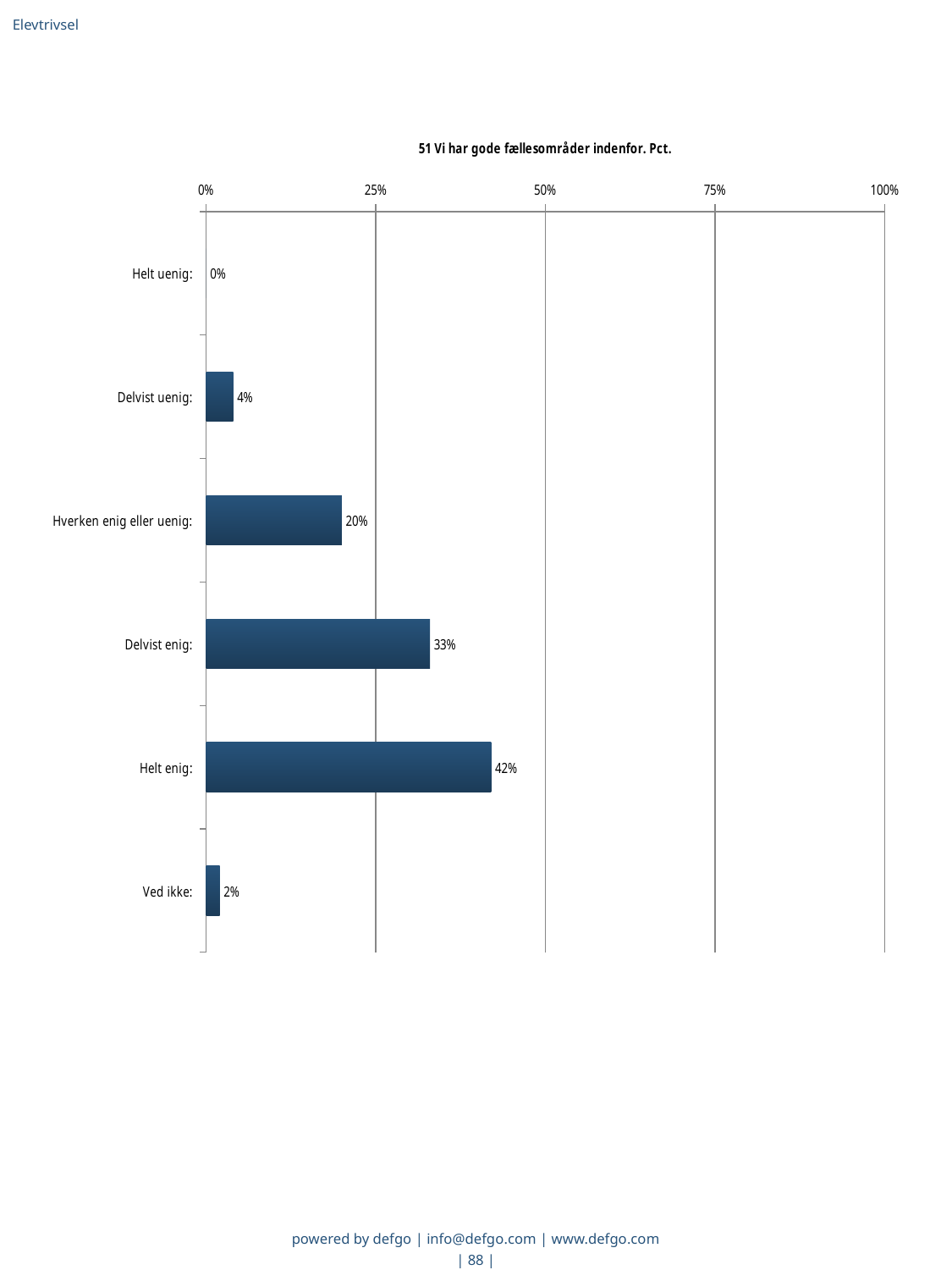
What kind of chart is shown on the slide? bar chart Is the value for "Helt enig" greater or less than 50%? less Which is larger, the value for "Delvist enig" or the value for "Hverken enig eller uenig"? Delvist enig What is the value for "Ved ikke"? 2% Which category has the lowest value? Helt uenig What is the value for "Hverken enig eller uenig"? 20% How many categories are shown on the chart? 6 What is the value for "Delvist uenig"? 4% What is the value for "Helt enig"? 42% What is the difference between the values for "Helt enig" and "Delvist enig"? 9% What is the title of the chart? 51 Vi har gode fællesområder indenfor. Pct. Which category has the highest value? Helt enig